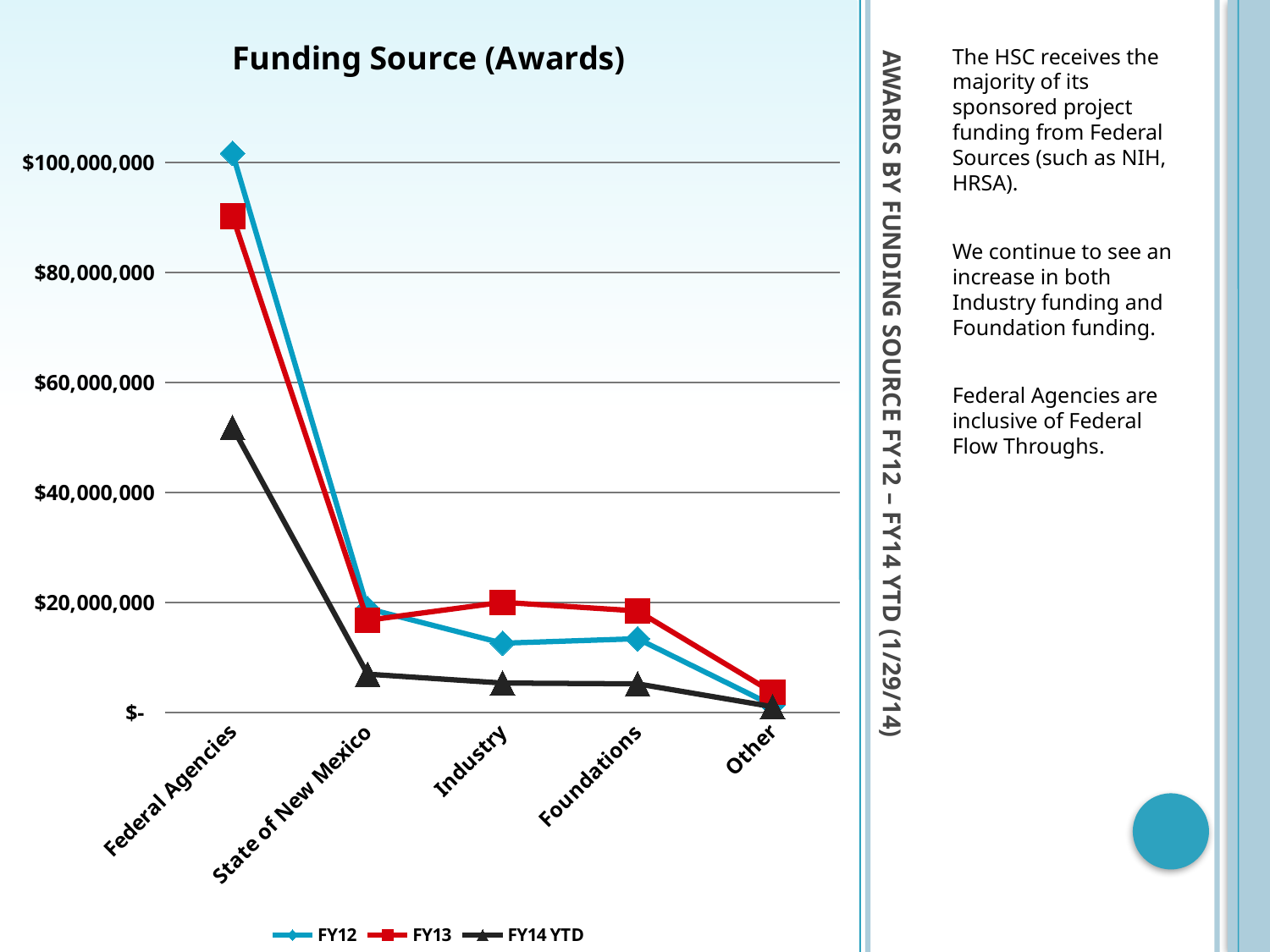
What kind of chart is shown on the slide? line chart How many funding source categories are plotted on the x axis? 5 Does the FY14 YTD line generally rise or fall from Federal Agencies to Other? fall For Federal Agencies, which is larger: the FY13 value or the FY14 YTD value? FY13 Which funding source has the highest FY12 value? Federal Agencies Is the FY13 value for Industry greater or less than $40,000,000? less How many series does the legend list? 3 Is the FY14 YTD value for Federal Agencies greater or less than $60,000,000? less Is the FY12 value for Federal Agencies greater or less than $80,000,000? greater What is the title of the chart? Funding Source (Awards) For Industry, which is larger: the FY13 value or the FY14 YTD value? FY13 Which funding source has the lowest FY13 value? Other